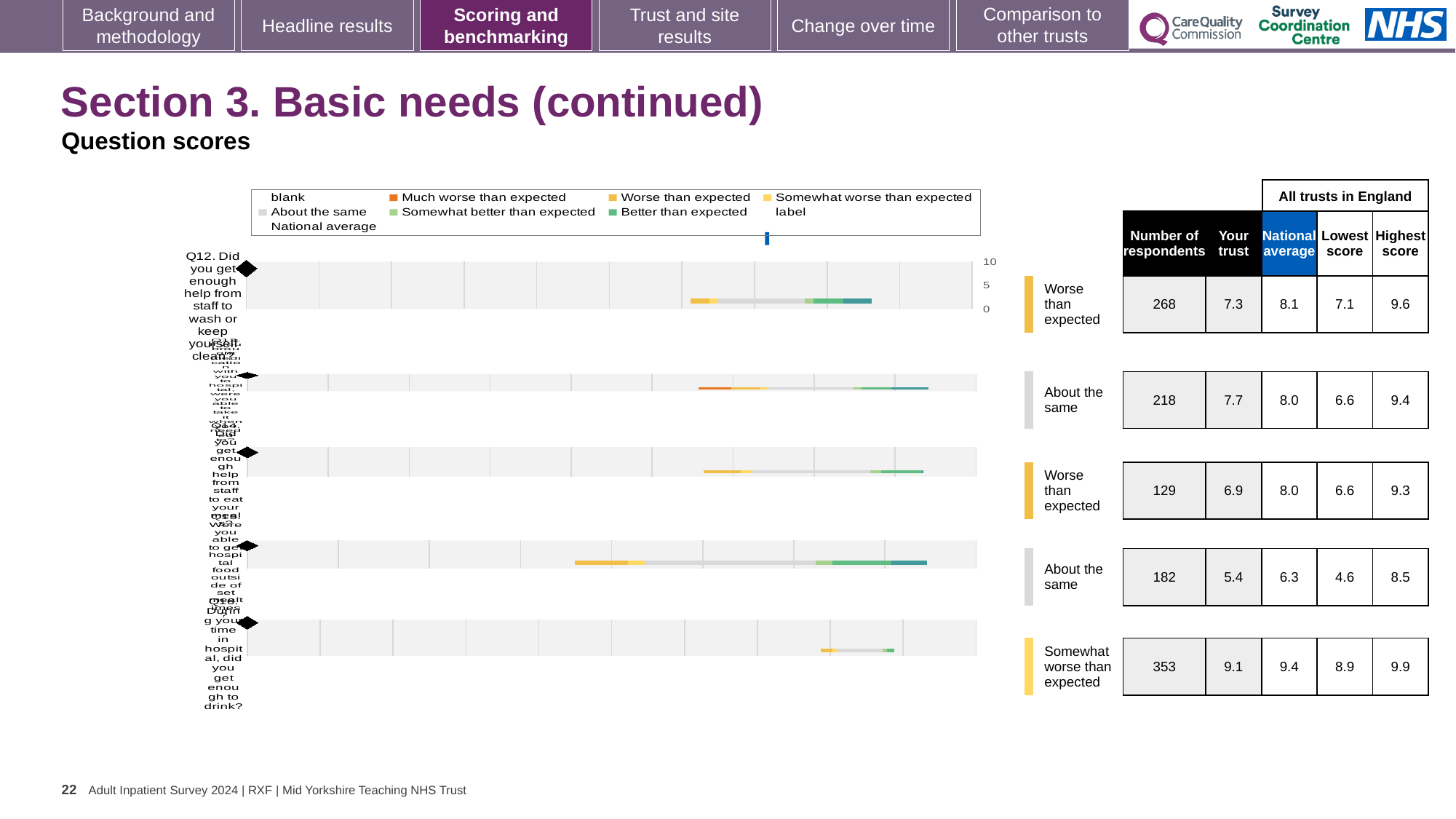
How many respondents are listed for the fourth question row? 182 What is the highest score among all trusts in England for the fifth (bottom) question row? 9.9 For the fourth question row, what is the difference between the highest score (8.5) and the lowest score (4.6) across all trusts in England? 3.9 For the second question row, is the 'Your trust' score higher or lower than the national average? lower For the third question row, what is the difference between the national average (8.0) and the 'Your trust' score (6.9)? 1.1 Which question row has the lowest 'Your trust' score? the fourth row, 5.4 What is the national average score for the first (top) question row, Q12? 8.1 What kind of chart is used to show the question scores on this slide? bar chart What is the 'Your trust' score for the first (top) question row, Q12? 7.3 Which question row has the highest 'Your trust' score? the fifth (bottom) row, 9.1 What benchmark category is shown for the first (top) question row? Worse than expected How many question rows are plotted in the question scores chart? 5